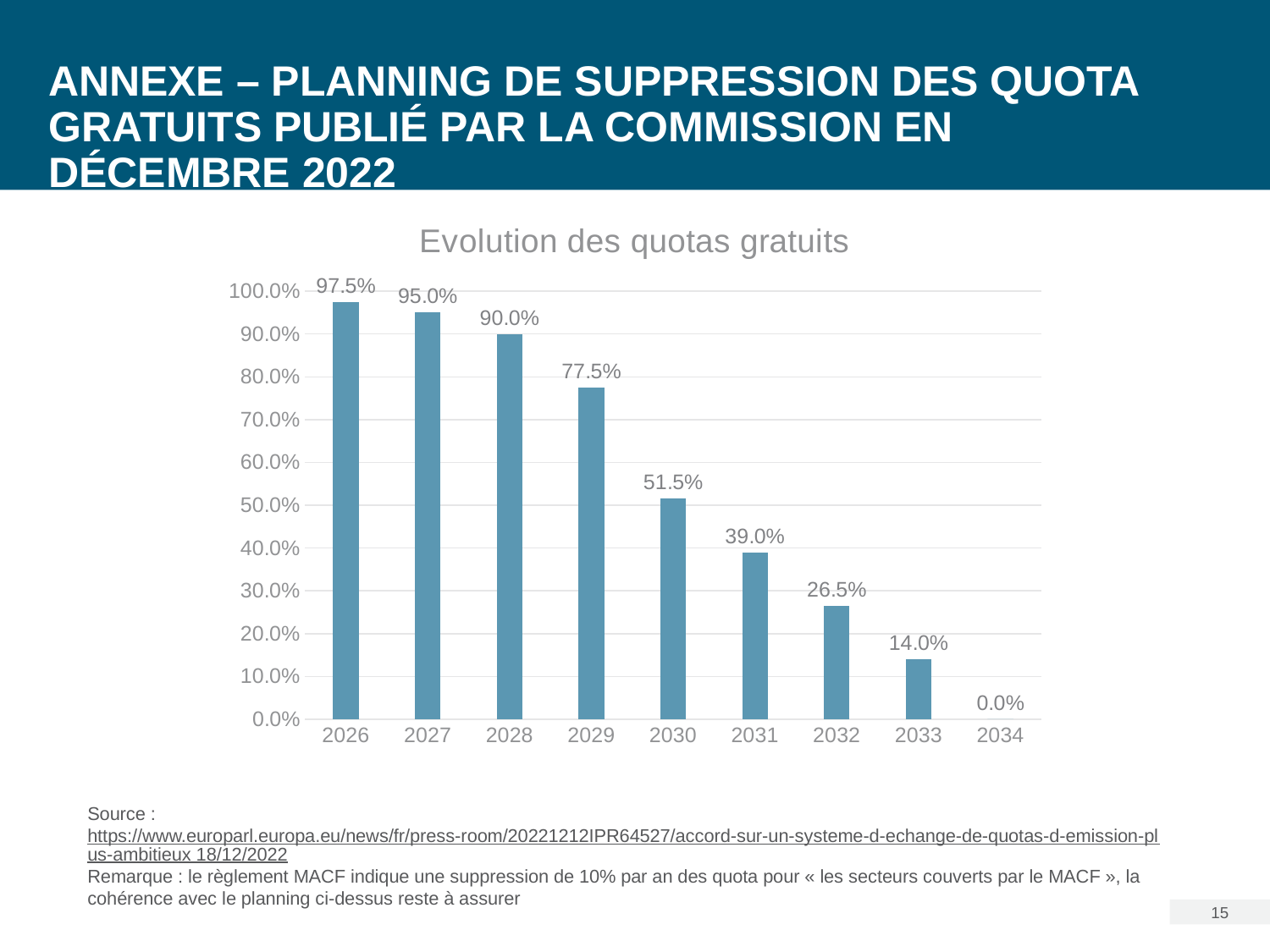
What is the value for 2028 in the chart? 90.0% Do the values rise or fall from 2026 to 2034? fall What is the difference between the values for 2029 and 2030? 26.0% Which is larger, the value for 2030 or the value for 2032? 2030 How many years are shown on the x axis of the chart? 9 What is the value for 2031 in the chart? 39.0% Which year has the highest value in the chart? 2026 What kind of chart is shown on the slide? bar chart Is the value for 2029 greater or less than 70.0%? greater What is the title of the chart? Evolution des quotas gratuits Which year has the lowest value in the chart? 2034 What is the value for 2033 in the chart? 14.0%